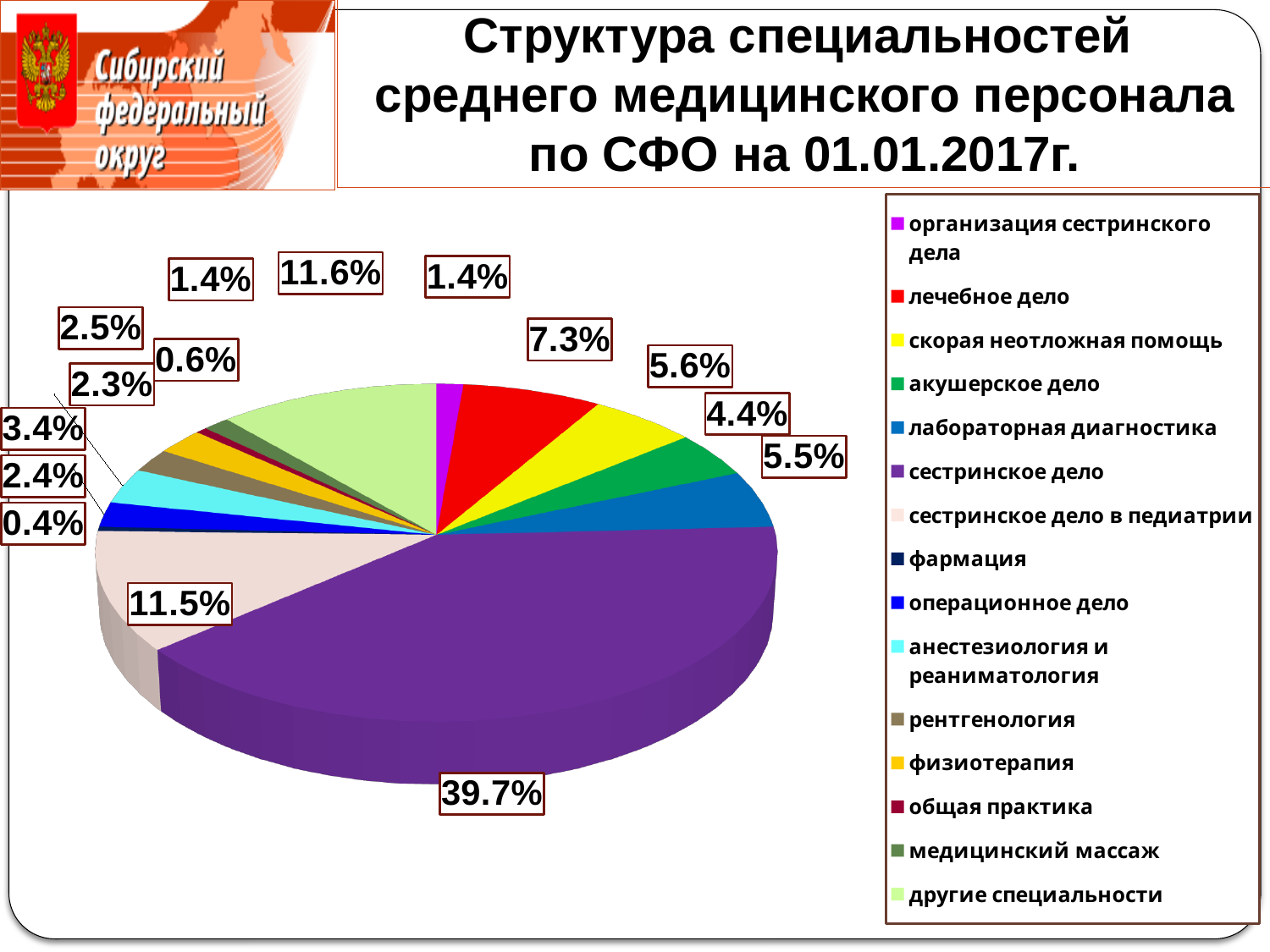
Which specialty has the smallest share of the pie? фармация What share of the pie does сестринское дело в педиатрии have? 11.5% What share of the pie does акушерское дело have? 4.4% Which specialty has the largest share of the pie? сестринское дело What is the difference in percentage points between сестринское дело and сестринское дело в педиатрии? 28.2 Which has a larger share: лабораторная диагностика or акушерское дело? лабораторная диагностика What share of the pie does другие специальности have? 11.6% How many specialties are listed in the legend? 15 What kind of chart is shown on the slide? pie chart